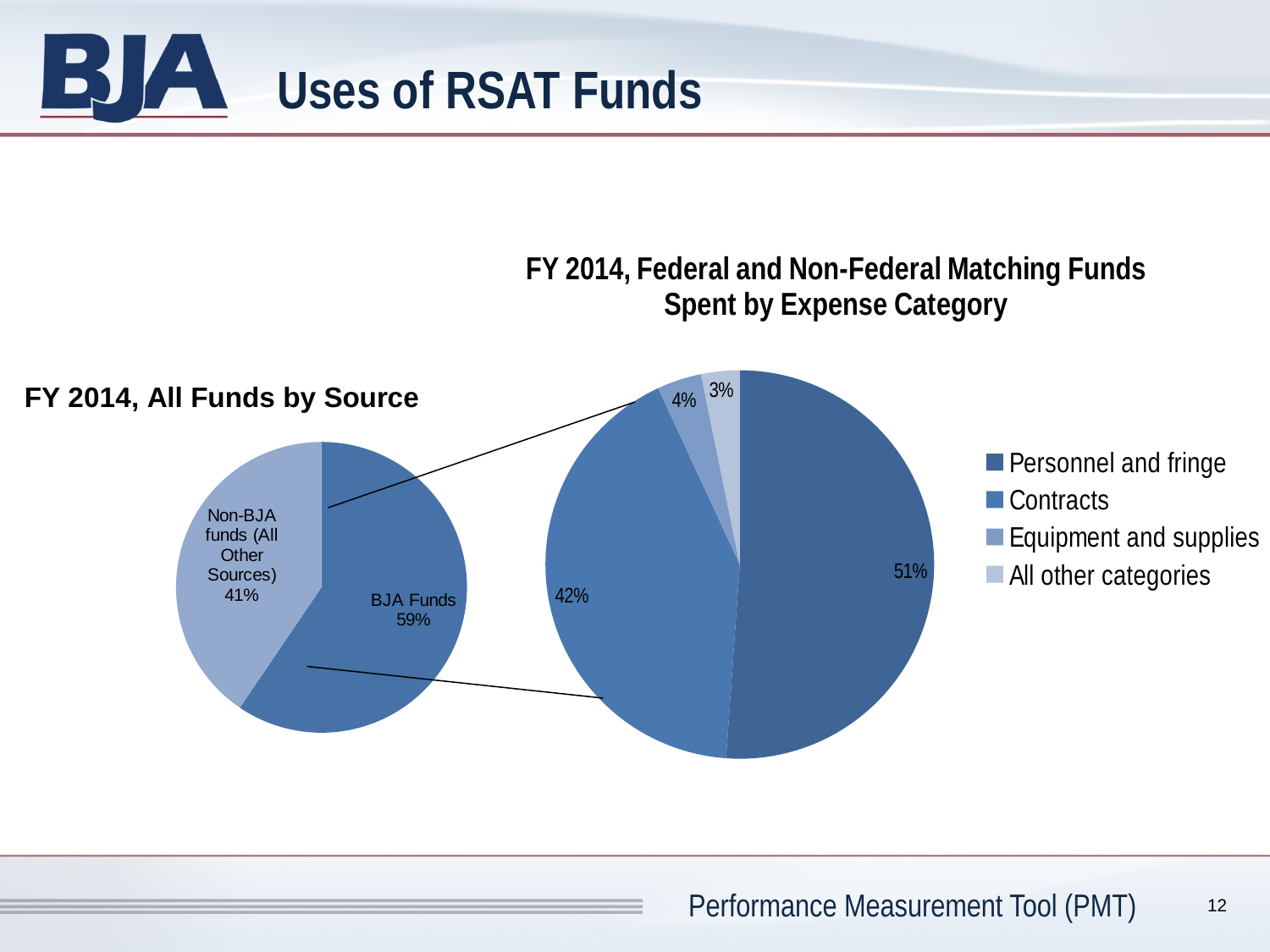
In the 'FY 2014, All Funds by Source' chart, what share of funds comes from BJA Funds? 59% In the 'FY 2014, Federal and Non-Federal Matching Funds Spent by Expense Category' chart, which expense category has the largest share? Personnel and fringe In the 'FY 2014, Federal and Non-Federal Matching Funds Spent by Expense Category' chart, what share is Personnel and fringe? 51% In the 'FY 2014, Federal and Non-Federal Matching Funds Spent by Expense Category' chart, how many percentage points larger is Personnel and fringe than Contracts? 9 In the 'FY 2014, Federal and Non-Federal Matching Funds Spent by Expense Category' chart, which expense category has the smallest share? All other categories In the 'FY 2014, Federal and Non-Federal Matching Funds Spent by Expense Category' chart, what share is Contracts? 42% How many expense categories does the legend of the 'FY 2014, Federal and Non-Federal Matching Funds Spent by Expense Category' chart list? 4 In the 'FY 2014, All Funds by Source' chart, which source has the larger share? BJA Funds In the 'FY 2014, All Funds by Source' chart, how many percentage points larger is the BJA Funds share than the Non-BJA funds share? 18 What type of chart is the 'FY 2014, All Funds by Source' chart? Pie chart